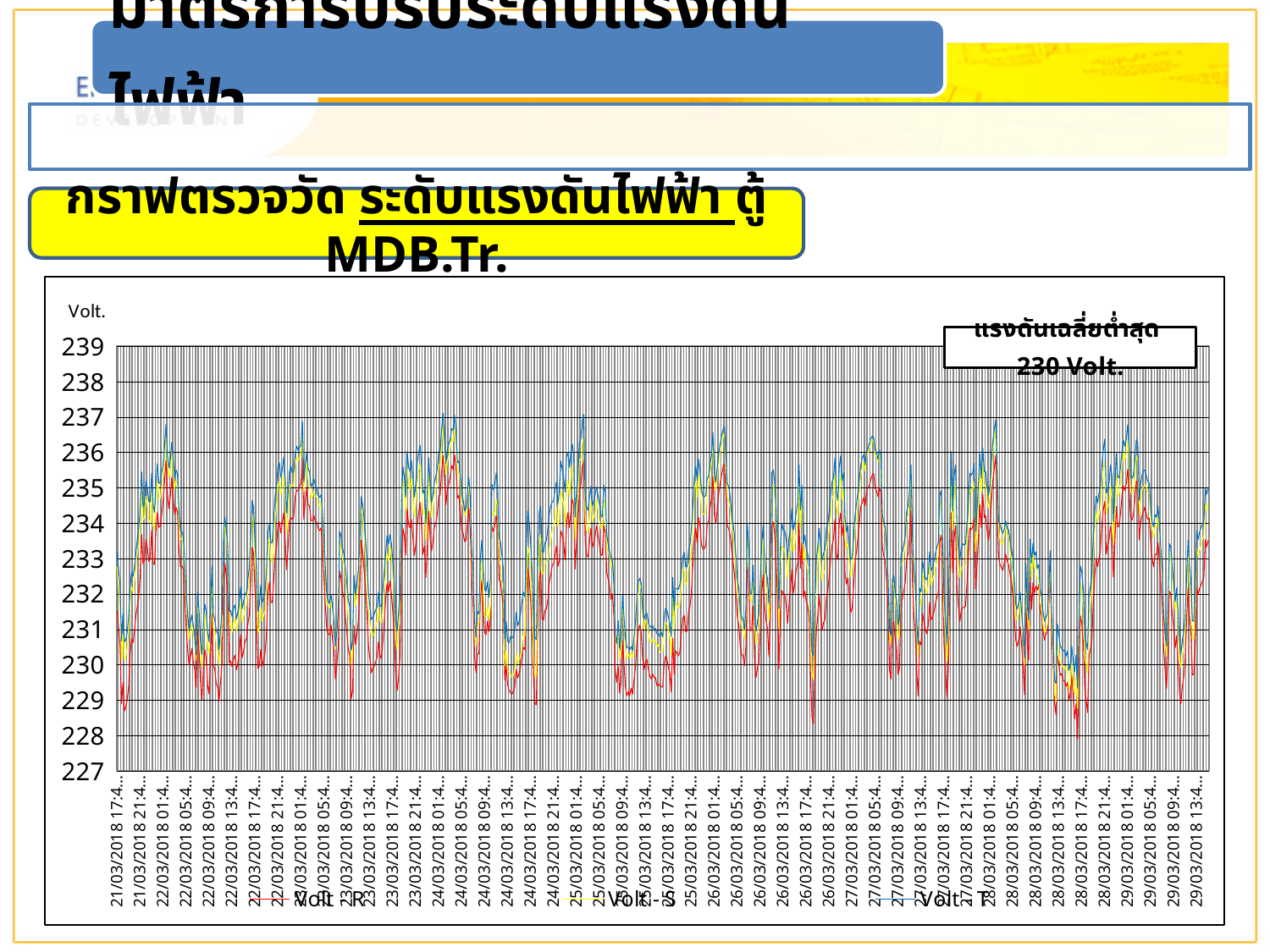
Is the lowest value plotted on the chart greater or less than 227? greater Is the highest value plotted on the chart greater or less than 238? less What kind of chart is shown on the slide? line chart How many series does the chart's legend list? 3 What minimum average voltage is stated in the text box on the chart? 230 Volt. What are the names of the series listed in the chart's legend? Volt - R, Volt - S, Volt - T